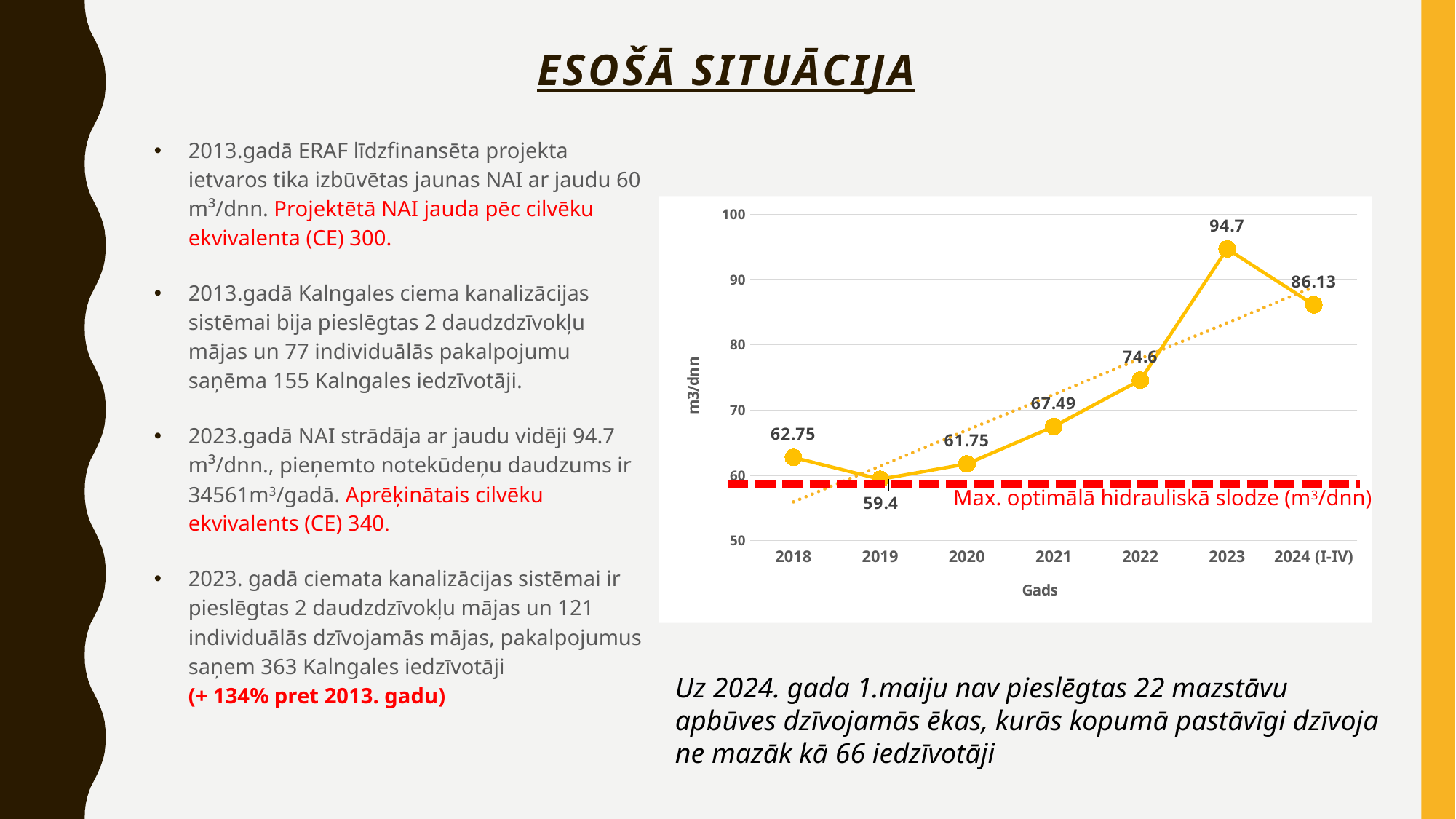
Which year has the highest value on the chart? 2023 What is the value for 2024 (I-IV) on the chart? 86.13 What is the difference between the values for 2023 and 2022? 20.1 Which is larger, the value for 2018 or the value for 2020? 2018 Which year has the lowest value on the chart? 2019 What is the label of the y axis of the chart? m3/dnn What is the value for 2021 on the chart? 67.49 How many years are plotted on the x axis of the chart? 7 Is the value for 2022 greater or less than 70? greater What is the value for 2023 on the chart? 94.7 What kind of chart is shown on the slide? Line chart What is the value for 2019 on the chart? 59.4